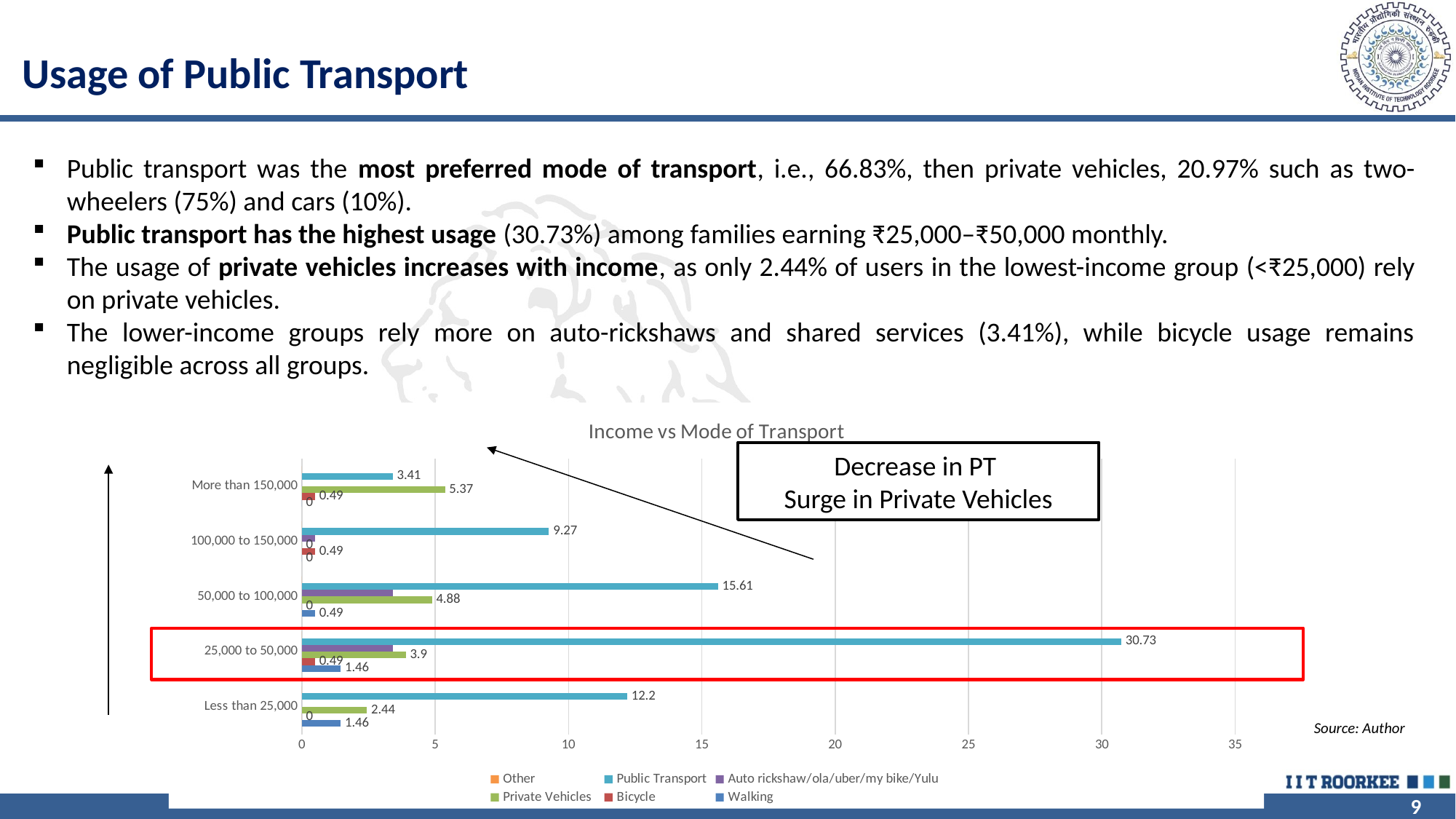
What is the Public Transport value for the 25,000 to 50,000 income group? 30.73 Which income group has the lowest Public Transport value? More than 150,000 What type of chart is shown on the slide? Bar chart What is the Private Vehicles value for the More than 150,000 income group? 5.37 What is the difference between the Public Transport values for 50,000 to 100,000 and 100,000 to 150,000? 6.34 How many income groups are shown on the chart? 5 Which income group has the highest Public Transport value? 25,000 to 50,000 What is the Walking value for the 25,000 to 50,000 income group? 1.46 Which income group has a larger Public Transport value: Less than 25,000 or 50,000 to 100,000? 50,000 to 100,000 What is the Private Vehicles value for the Less than 25,000 income group? 2.44 How many series does the legend list? 6 Is the Auto rickshaw/ola/uber/my bike/Yulu value for the 25,000 to 50,000 group greater or less than 5? less